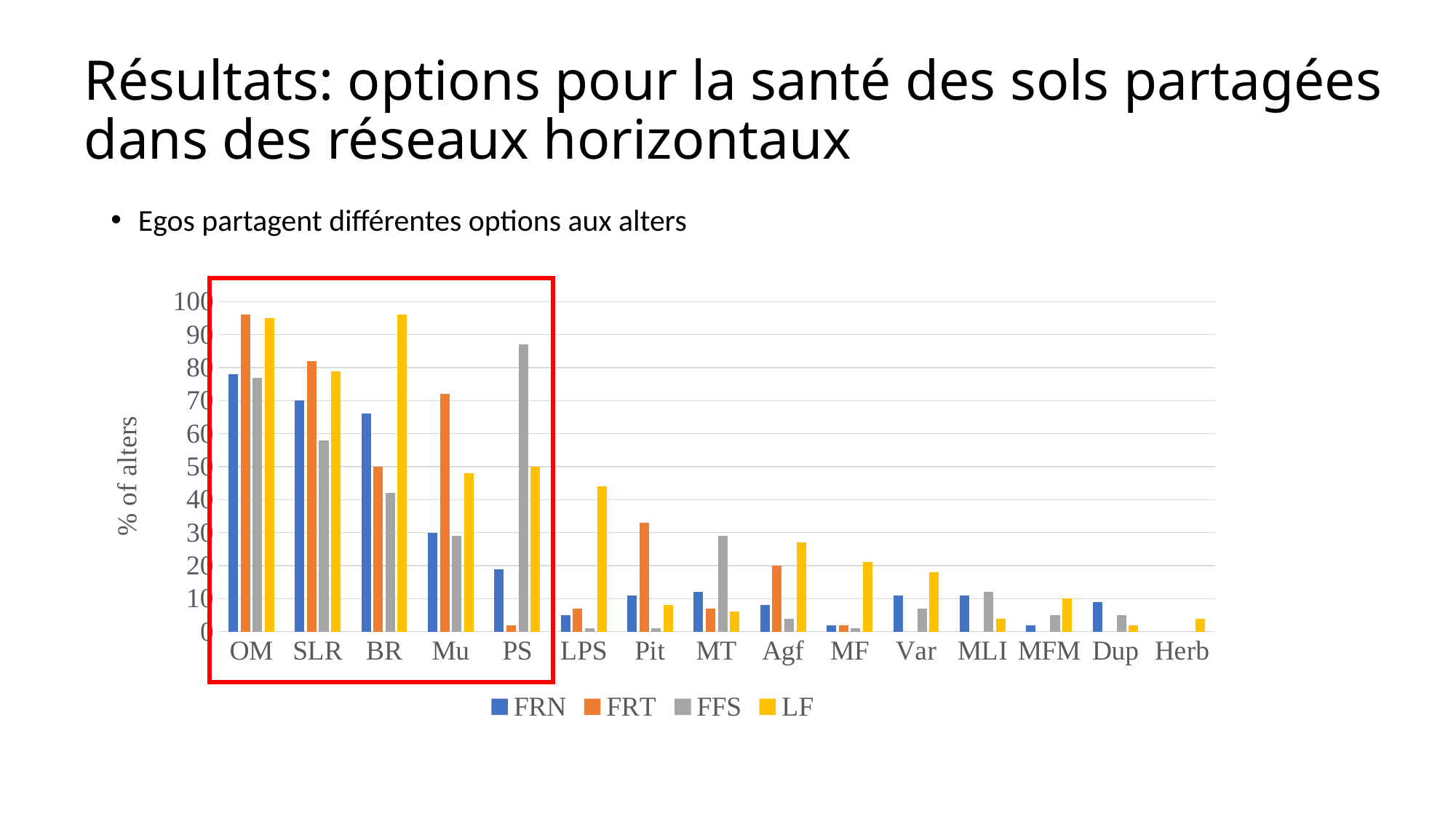
What kind of chart is shown on the slide? bar chart Which series has the highest bar for the category PS? FFS Is the FRN value for OM greater or less than 70? greater How many series does the legend list? 4 Which series has the highest bar for the category BR? LF Is the FFS value for PS greater or less than 80? greater Which is larger, the FRT value for SLR or the FRT value for BR? SLR What is the label of the y axis? % of alters How many categories are shown along the x axis? 15 Is the FRN value for PS greater or less than 30? less Which category has the tallest FFS bar? PS